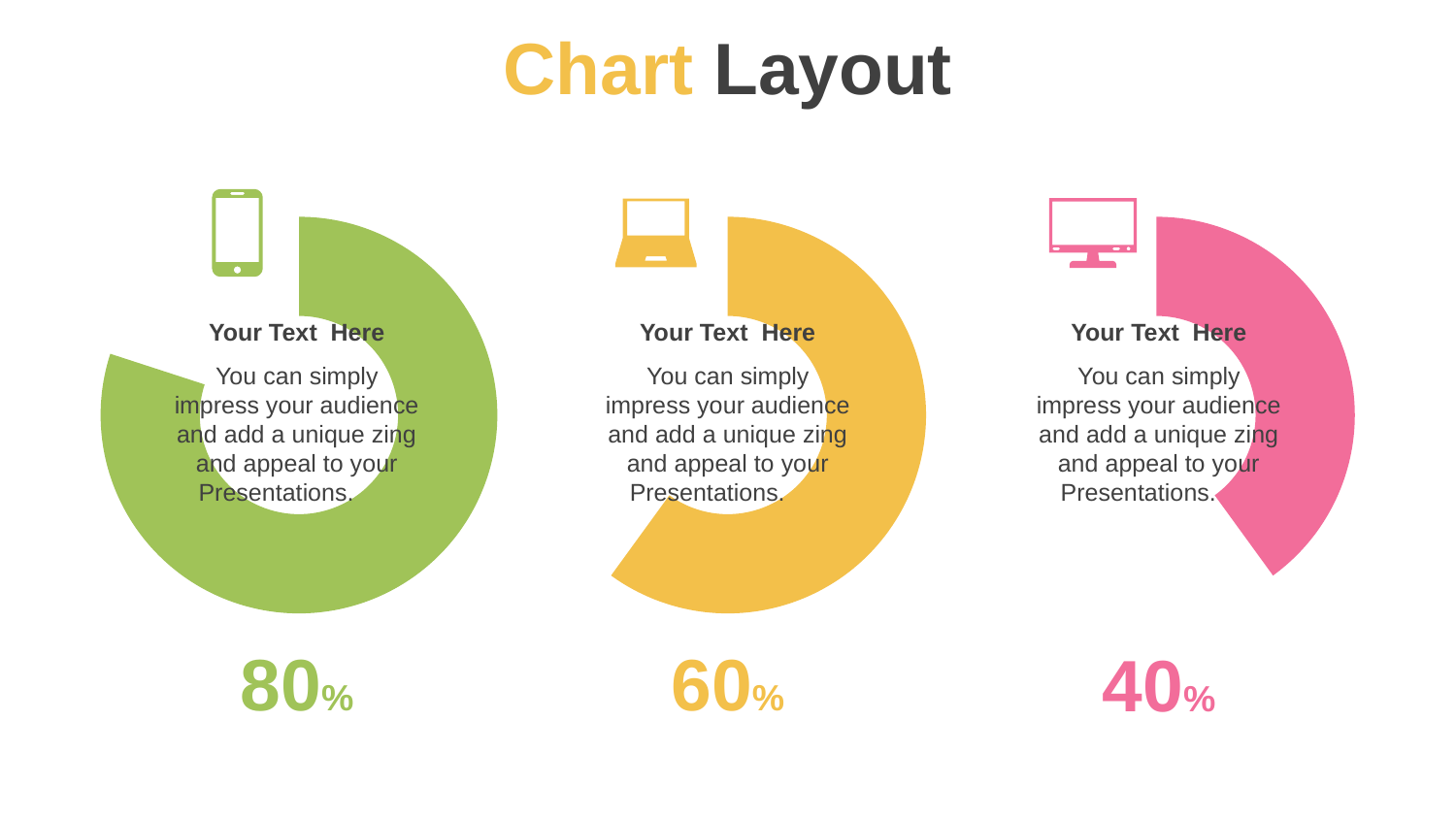
What value is shown below the left (green) donut chart? 80% What value is shown below the right (pink) donut chart? 40% What colour is the donut chart with the 60% value? Yellow What is the difference between the percentage of the left chart and the percentage of the right chart? 40% Which of the three donut charts shows the lowest percentage? The right (pink) chart, 40% What is the difference between the percentage of the middle chart and the percentage of the right chart? 20% What kind of chart is used on this slide? Donut chart What value is shown below the middle (yellow) donut chart? 60% Which of the three donut charts shows the highest percentage? The left (green) chart, 80% How many donut charts are on the slide? 3 Which is larger, the percentage of the middle chart or the percentage of the right chart? The middle chart (60%) What is the title of the slide? Chart Layout